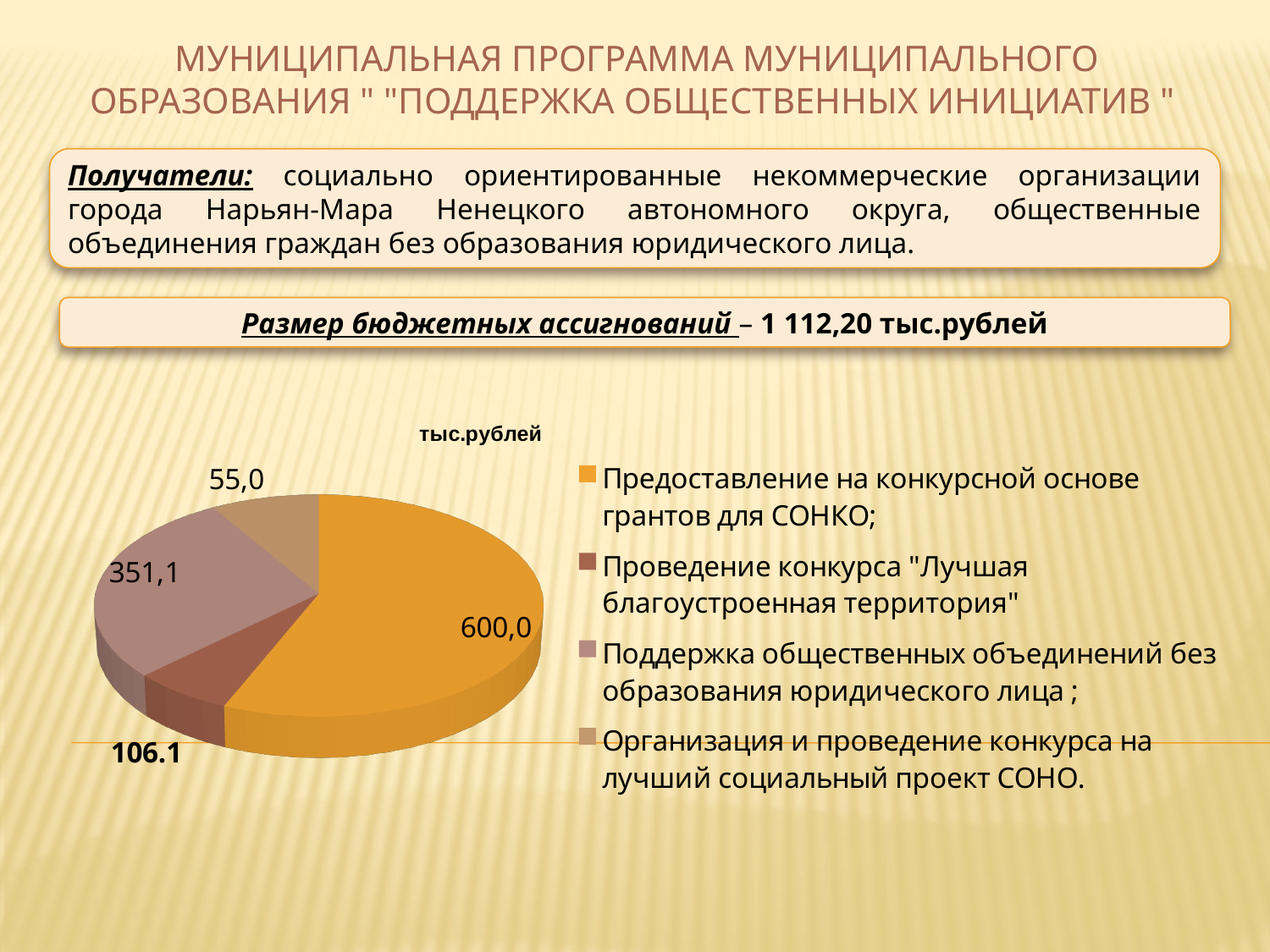
What is the value for "Поддержка общественных объединений без образования юридического лица"? 351,1 What colour is the slice for "Предоставление на конкурсной основе грантов для СОНКО"? Orange What is the title of the pie chart? тыс.рублей How many slices does the pie chart have? 4 What is the value for "Предоставление на конкурсной основе грантов для СОНКО"? 600,0 What kind of chart is shown on the slide? Pie chart What is the value for "Организация и проведение конкурса на лучший социальный проект СОНО"? 55,0 Which is larger: the value for "Проведение конкурса "Лучшая благоустроенная территория"" or the value for "Организация и проведение конкурса на лучший социальный проект СОНО"? Проведение конкурса "Лучшая благоустроенная территория" What is the difference between the value for "Предоставление на конкурсной основе грантов для СОНКО" and the value for "Поддержка общественных объединений без образования юридического лица"? 248,9 Which category has the largest slice of the pie? Предоставление на конкурсной основе грантов для СОНКО What is the value for "Проведение конкурса "Лучшая благоустроенная территория""? 106.1